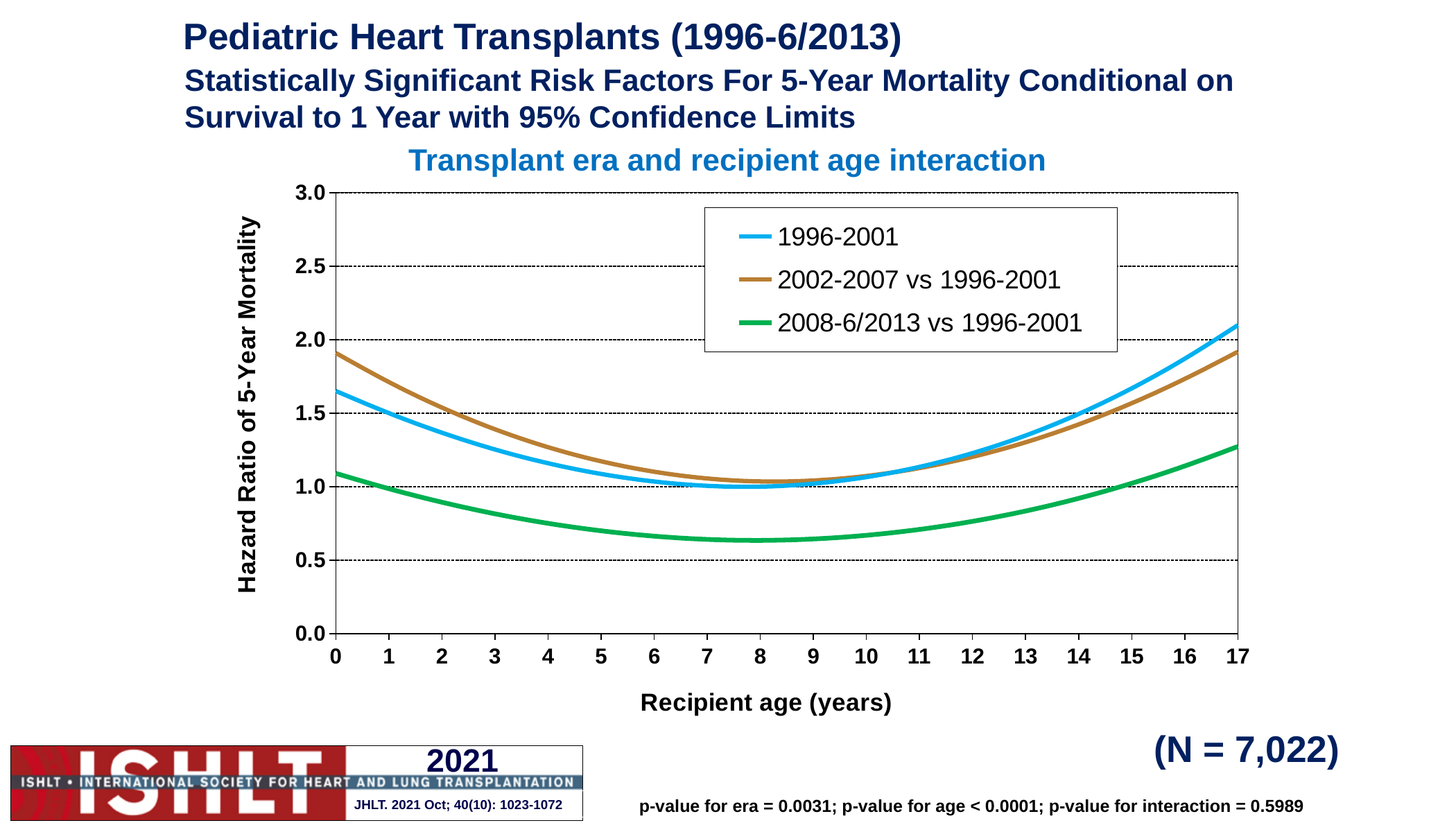
At recipient age 17, which series has the higher value: 1996-2001 or 2002-2007 vs 1996-2001? 1996-2001 What kind of chart is shown on the slide? line chart Which series has the lowest hazard ratio across all recipient ages? 2008-6/2013 vs 1996-2001 How many series does the legend list? 3 Is the value for the 2002-2007 vs 1996-2001 series at recipient age 0 greater or less than 1.5? greater Is the value for the 2008-6/2013 vs 1996-2001 series at recipient age 17 greater or less than 1.0? greater What is the label of the y axis? Hazard Ratio of 5-Year Mortality Is the value for the 2008-6/2013 vs 1996-2001 series at recipient age 8 greater or less than 1.0? less Do the values for the 1996-2001 series rise or fall as recipient age increases from 8 to 17 years? rise What is the title of the chart? Transplant era and recipient age interaction At recipient age 0, which series has the higher value: 1996-2001 or 2002-2007 vs 1996-2001? 2002-2007 vs 1996-2001